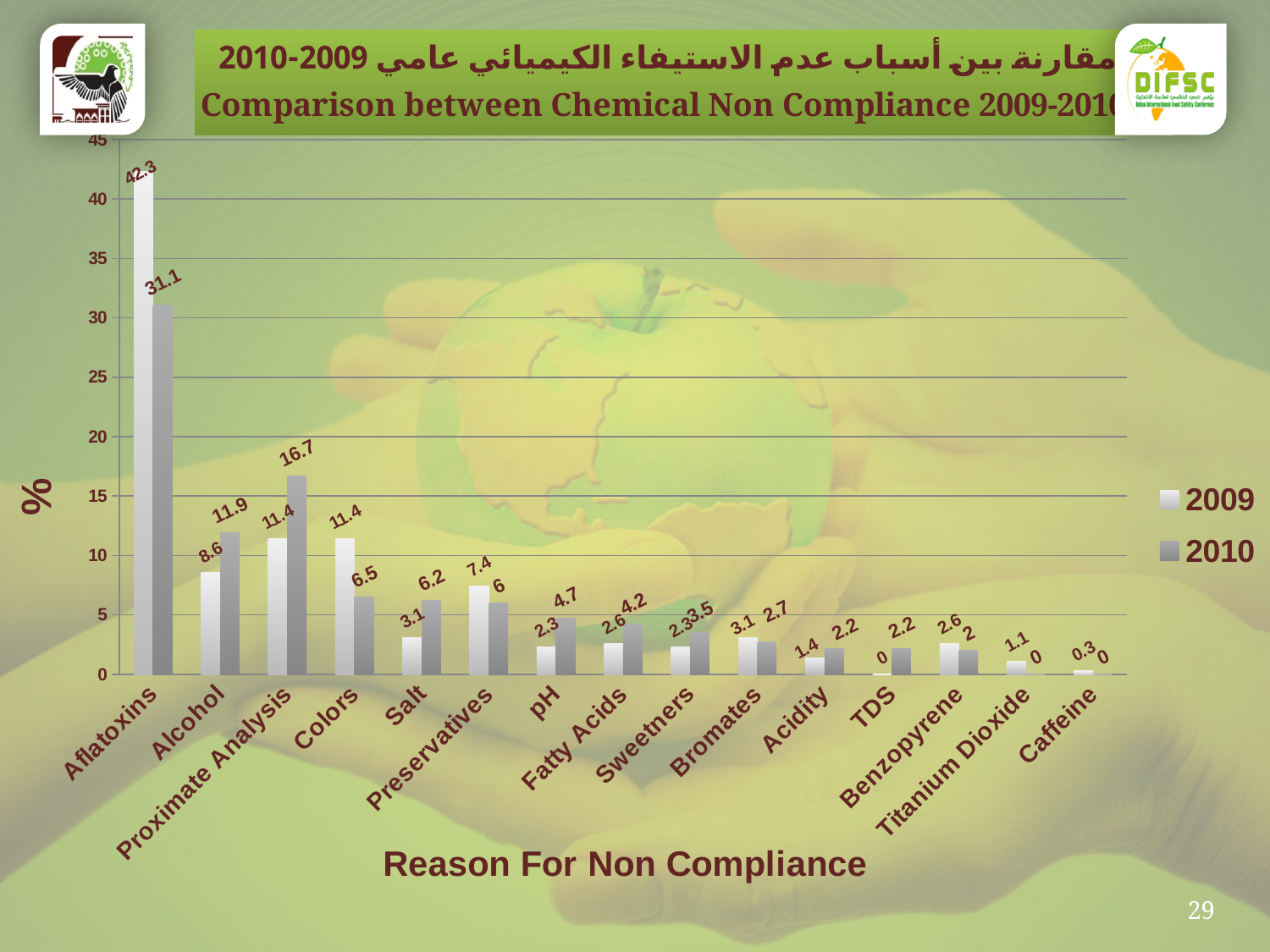
What kind of chart is shown on the slide? Bar chart What is the 2009 value for Aflatoxins? 42.3 What is the 2009 value for Preservatives? 7.4 What is the difference between the 2009 and 2010 values for Aflatoxins? 11.2 Which is larger for Colors, the 2009 value or the 2010 value? 2009 Which reason for non compliance has the lowest 2009 value? TDS Which reason for non compliance has the highest 2010 value? Aflatoxins What is the difference between the 2010 and 2009 values for Salt? 3.1 What is the 2010 value for Alcohol? 11.9 How many reasons for non compliance are shown on the x axis? 15 What is the 2010 value for Proximate Analysis? 16.7 How many series does the legend list? 2